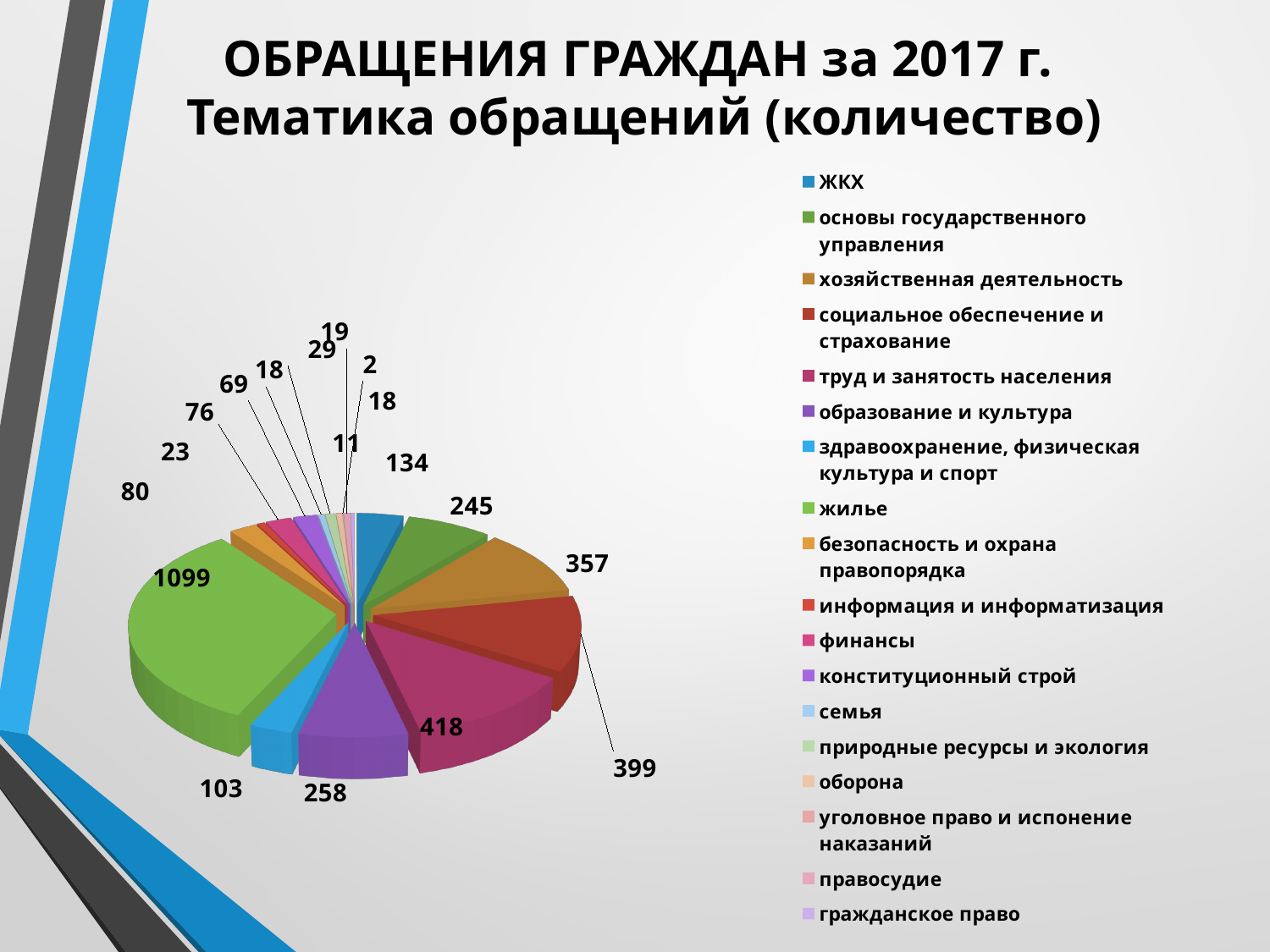
What is the value for образование и культура? 258 What is the value for жилье? 1099 Which category has the highest value? жилье What type of chart is shown on the slide? pie chart What is the value for труд и занятость населения? 418 What is the title of the slide? ОБРАЩЕНИЯ ГРАЖДАН за 2017 г. Тематика обращений (количество) What is the value for хозяйственная деятельность? 357 What is the value for ЖКХ? 134 What is the smallest value shown on the chart? 2 Which is larger: труд и занятость населения or социальное обеспечение и страхование? труд и занятость населения What is the difference between the values for жилье and труд и занятость населения? 681 How many categories does the legend list? 18